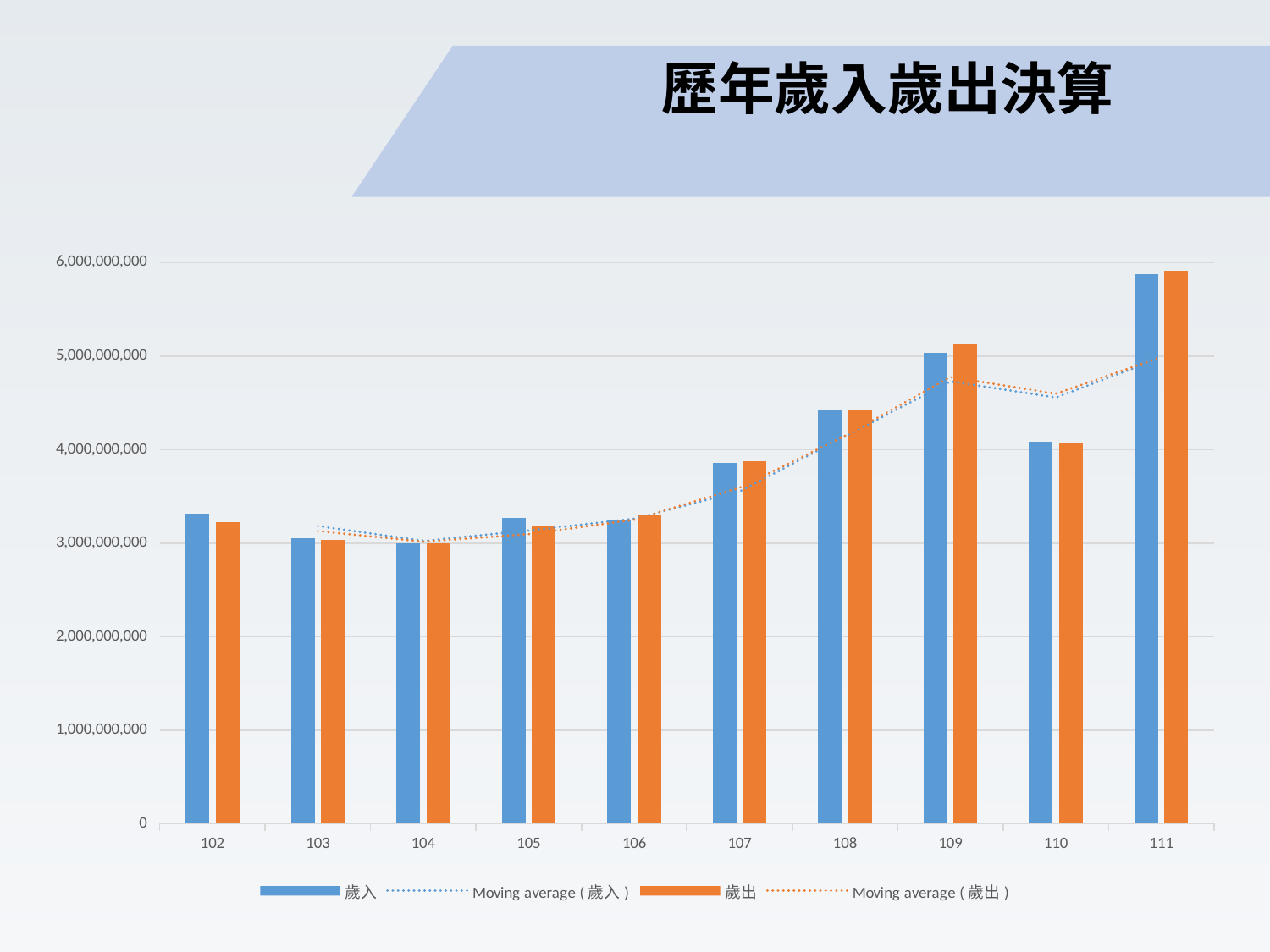
Which is larger, the 歲入 value for 109 or the 歲入 value for 110? 109 What is the title of the slide? 歷年歲入歲出決算 Which year has the highest 歲入 bar? 111 Is the 歲入 value for 102 greater or less than 3,000,000,000? greater Is the 歲入 value for 111 greater or less than 5,000,000,000? greater What kind of chart is shown on the slide? Bar chart How many years (categories) are shown on the x axis? 10 Is the 歲入 value for 108 greater or less than 4,000,000,000? greater Which year has the lowest 歲出 bar? 104 Overall, do the 歲出 bars rise or fall from 104 to 111? Rise How many series does the legend list? 4